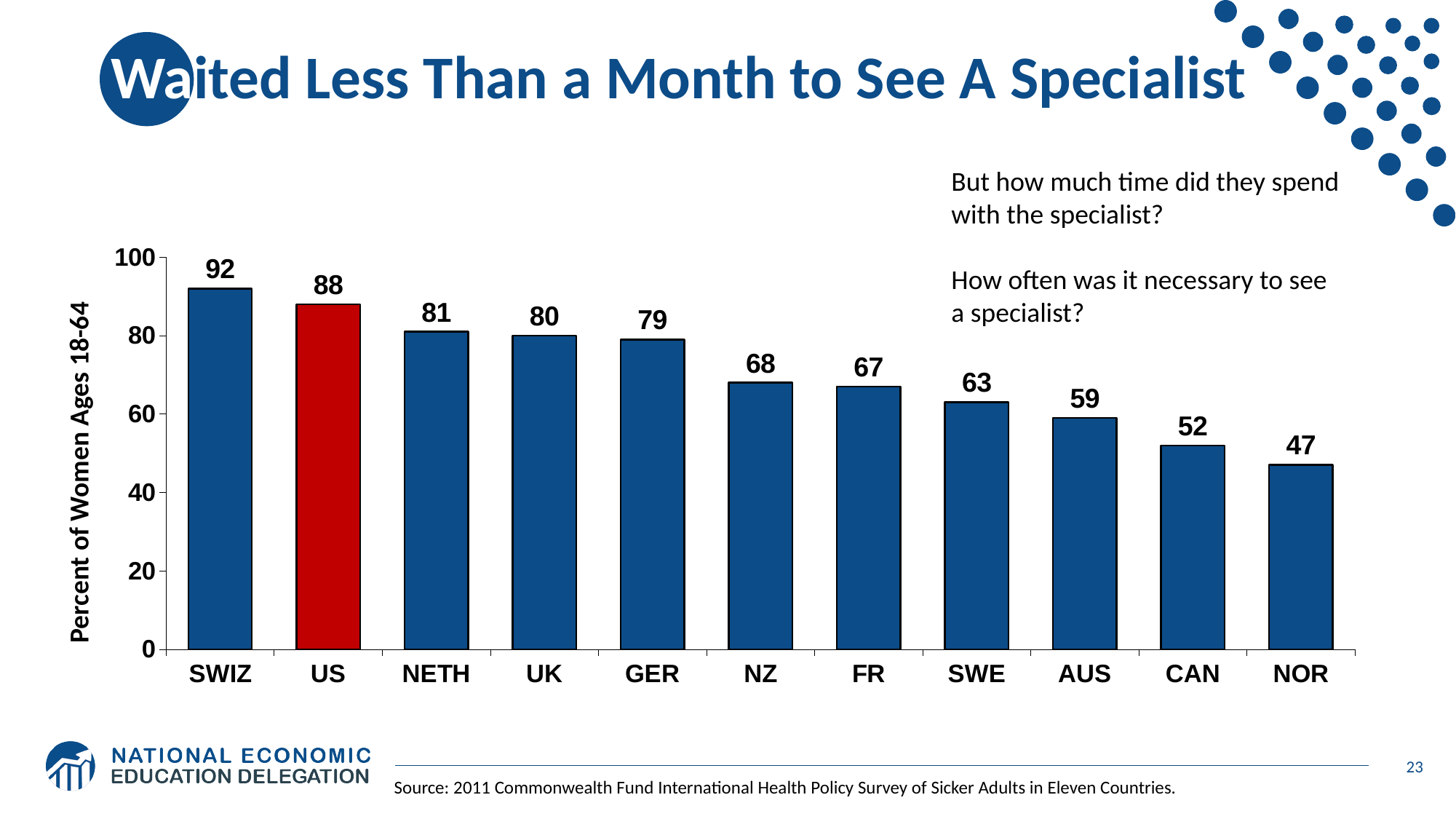
Which country has the lowest value? NOR What is the value for the US? 88 What is the value for GER? 79 Which country has the highest value? SWIZ Which is larger, the value for NZ or the value for SWE? NZ What kind of chart is shown on the slide? bar chart What is the difference between the values for SWIZ and the US? 4 Is the value for AUS greater or less than 60? less What is the difference between the values for CAN and NOR? 5 How many countries are shown on the chart? 11 Which country's bar is coloured red? US What is the value for NOR? 47